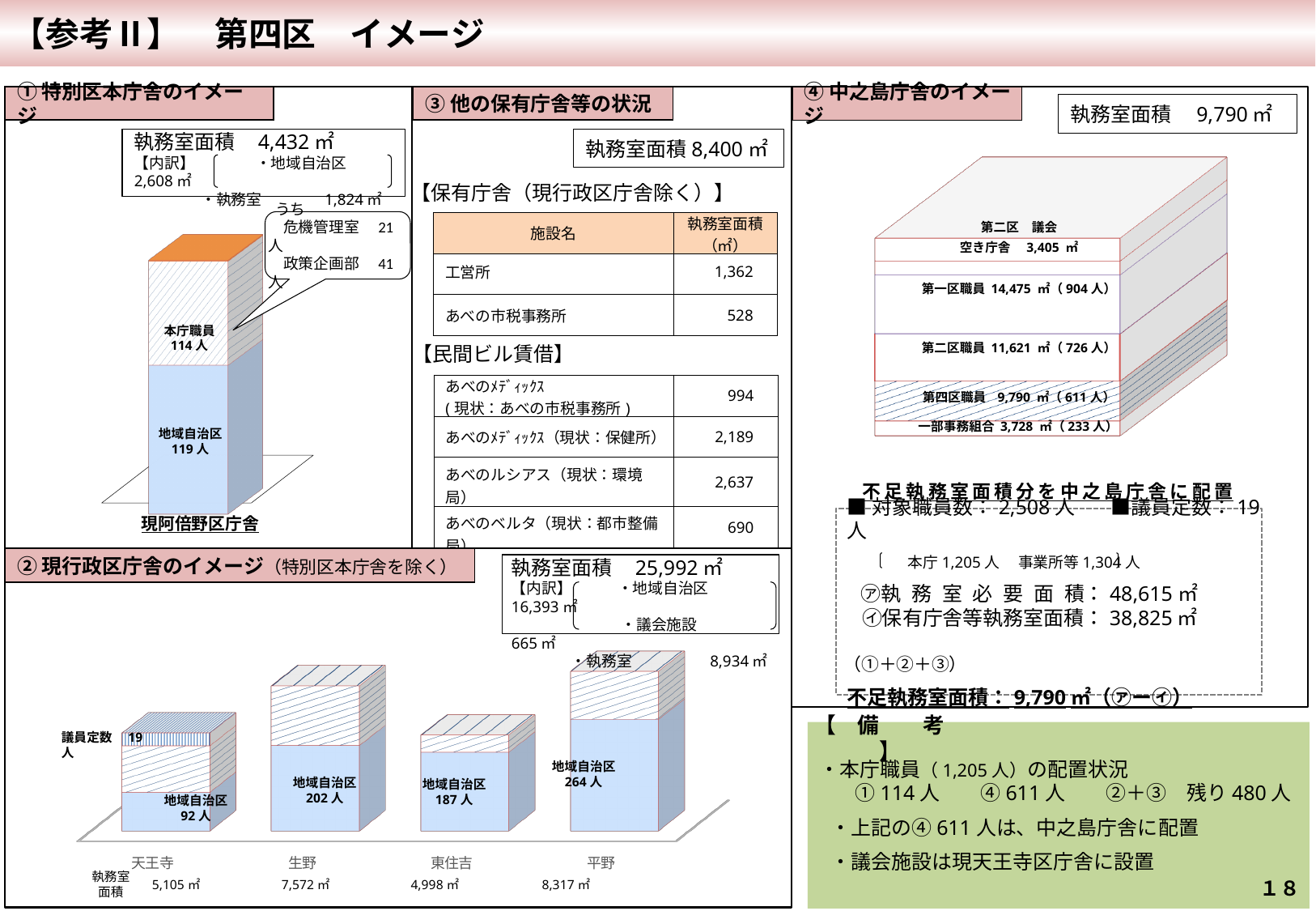
In the ④ 中之島庁舎のイメージ diagram, what is the difference in area between 第一区職員 and 第二区職員? 2,854 ㎡ In the ② 現行政区庁舎のイメージ diagram, what is the difference between the 地域自治区 staff of 平野 and 天王寺? 172 人 How many wards are shown in the ② 現行政区庁舎のイメージ diagram? 4 In the ② 現行政区庁舎のイメージ diagram, which ward has the largest number of 地域自治区 staff? 平野 In the ④ 中之島庁舎のイメージ diagram, which floor segment has the largest area? 第一区職員 In the ① 特別区本庁舎のイメージ diagram, how many 本庁職員 are shown? 114 人 In the ② 現行政区庁舎のイメージ diagram, which ward has the smallest 執務室面積? 東住吉 In the ④ 中之島庁舎のイメージ diagram, how many people are shown for 第四区職員? 611 人 In the ② 現行政区庁舎のイメージ diagram, which has more 地域自治区 staff, 生野 or 東住吉? 生野 In the ② 現行政区庁舎のイメージ diagram, what is the 執務室面積 shown for 生野? 7,572 ㎡ In the ② 現行政区庁舎のイメージ diagram, how many 地域自治区 staff are shown for 平野? 264 人 In the ④ 中之島庁舎のイメージ diagram, what is the area shown for 第一区職員? 14,475 ㎡